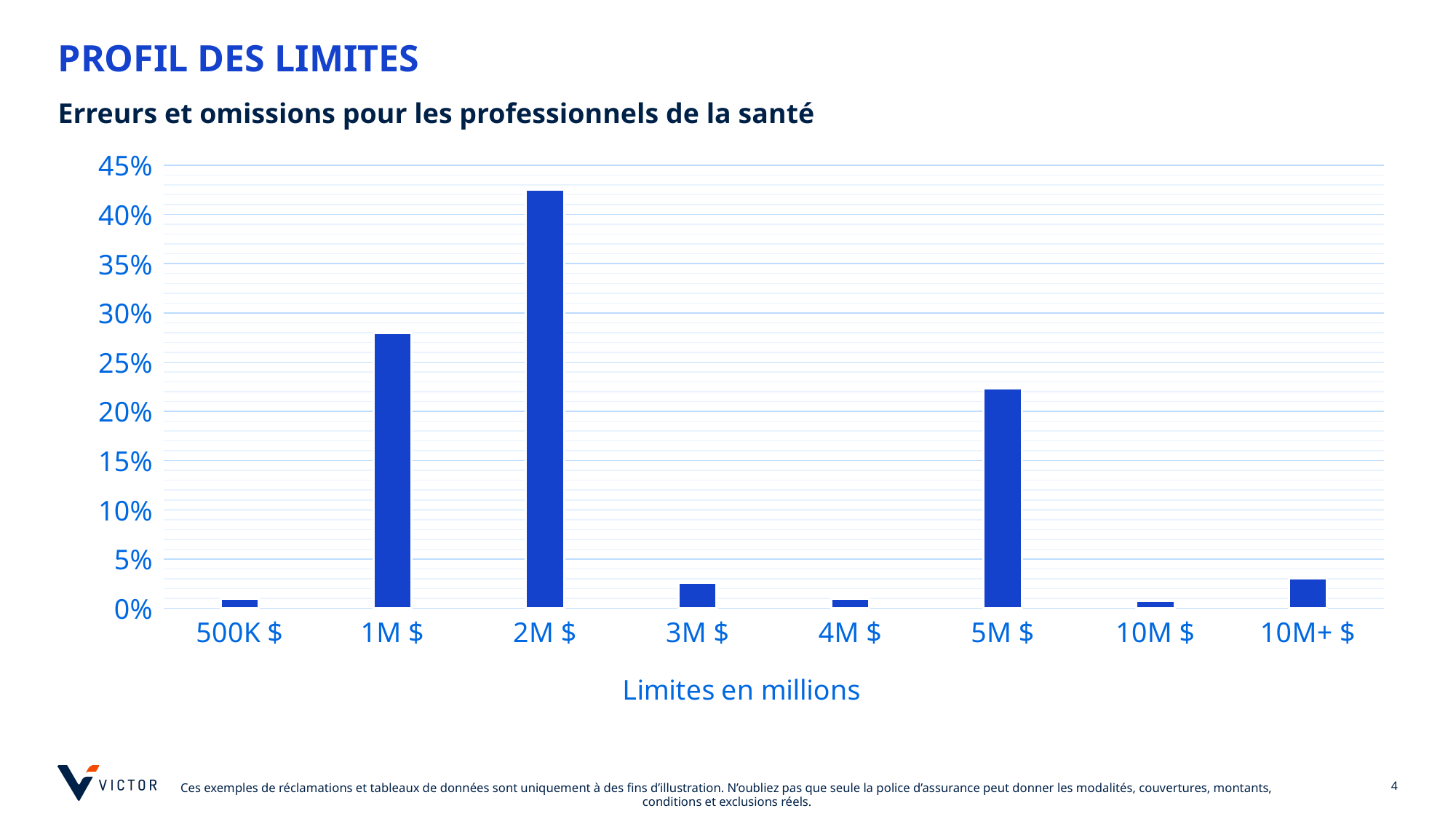
Is the value for 3M $ greater or less than 5%? less Is the value for 5M $ greater or less than 20%? greater Is the value for 1M $ greater or less than 30%? less What kind of chart is shown on the slide? bar chart Which limit category has the highest percentage? 2M $ How many limit categories are shown on the x axis? 8 What is the title of the x axis? Limites en millions Which has the larger value, 1M $ or 5M $? 1M $ Which has the larger value, 3M $ or 4M $? 3M $